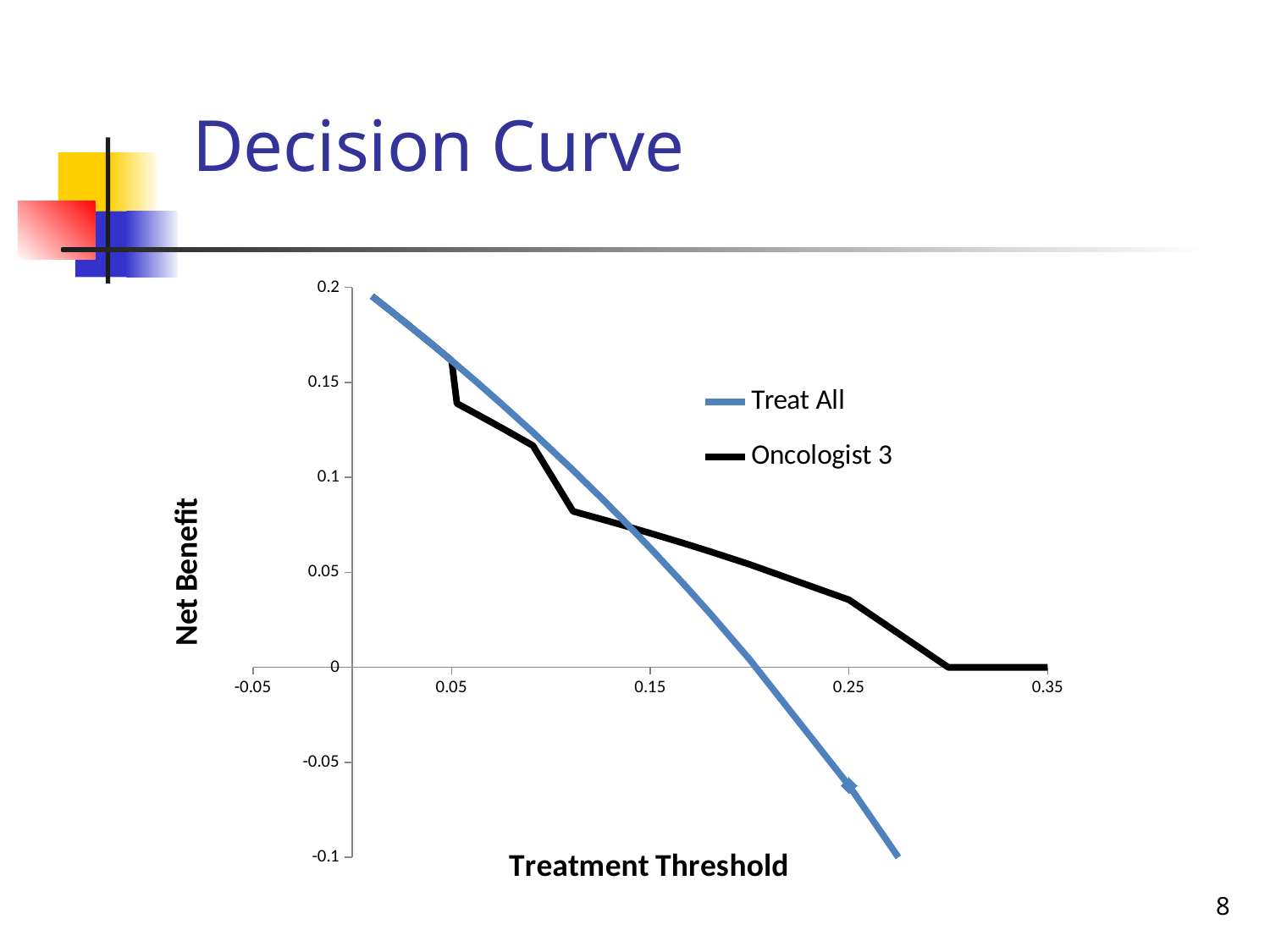
What kind of chart is shown on the slide? line chart What is the title of the chart? Decision Curve Which series is drawn in blue? Treat All Does the Oncologist 3 line rise or fall as the treatment threshold increases from 0.05 to 0.3? fall Does the Treat All line rise or fall as the treatment threshold increases? fall At a treatment threshold of 0.3, which series has the higher net benefit, Treat All or Oncologist 3? Oncologist 3 How many series does the legend list? 2 Is the net benefit for Treat All at a treatment threshold of 0.3 greater or less than -0.05? less Is the net benefit for Treat All at a treatment threshold of 0.25 greater or less than 0? less Is the net benefit for Oncologist 3 at a treatment threshold of 0.15 greater or less than 0.05? greater At a treatment threshold of 0.25, which series has the higher net benefit, Treat All or Oncologist 3? Oncologist 3 What is the label of the vertical axis? Net Benefit